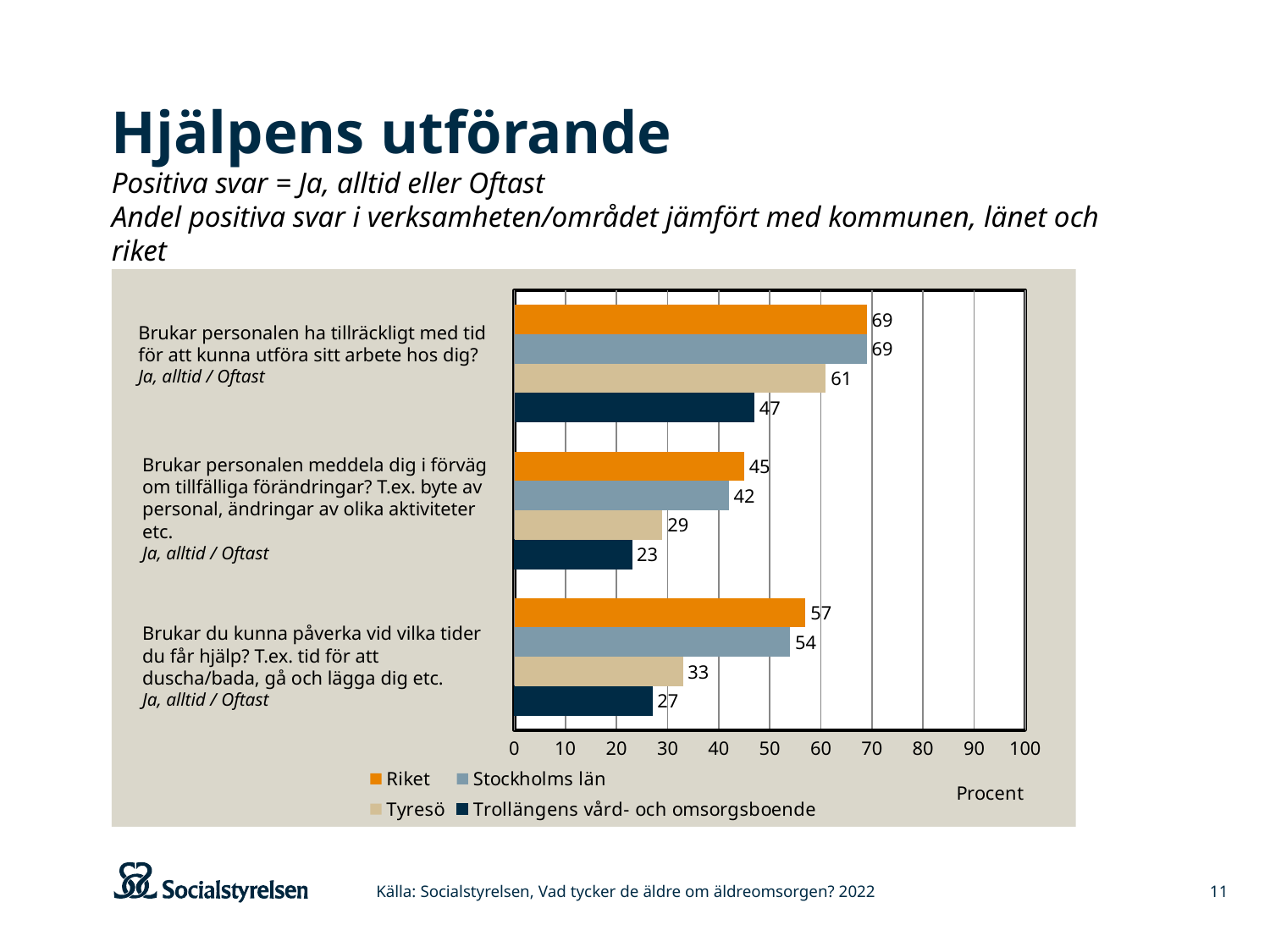
What is the value for Riket for the question 'Brukar du kunna påverka vid vilka tider du får hjälp?' 57 Which is larger for the question 'Brukar du kunna påverka vid vilka tider du får hjälp?': Tyresö or Stockholms län? Stockholms län How many series does the legend list? 4 What is the value for Tyresö for the question 'Brukar personalen meddela dig i förväg om tillfälliga förändringar?' 29 For which question does Trollängens vård- och omsorgsboende have its lowest value? Brukar personalen meddela dig i förväg om tillfälliga förändringar? What is the label of the x axis of the chart? Procent Which series has the lowest value for the question 'Brukar du kunna påverka vid vilka tider du får hjälp?' Trollängens vård- och omsorgsboende What is the value for Trollängens vård- och omsorgsboende for the question 'Brukar personalen ha tillräckligt med tid för att kunna utföra sitt arbete hos dig?' 47 What kind of chart is shown on the slide? Bar chart What is the value for Stockholms län for the question 'Brukar personalen meddela dig i förväg om tillfälliga förändringar?' 42 What is the difference between Riket and Trollängens vård- och omsorgsboende for the question 'Brukar personalen ha tillräckligt med tid för att kunna utföra sitt arbete hos dig?' 22 How many question categories are plotted in the chart? 3